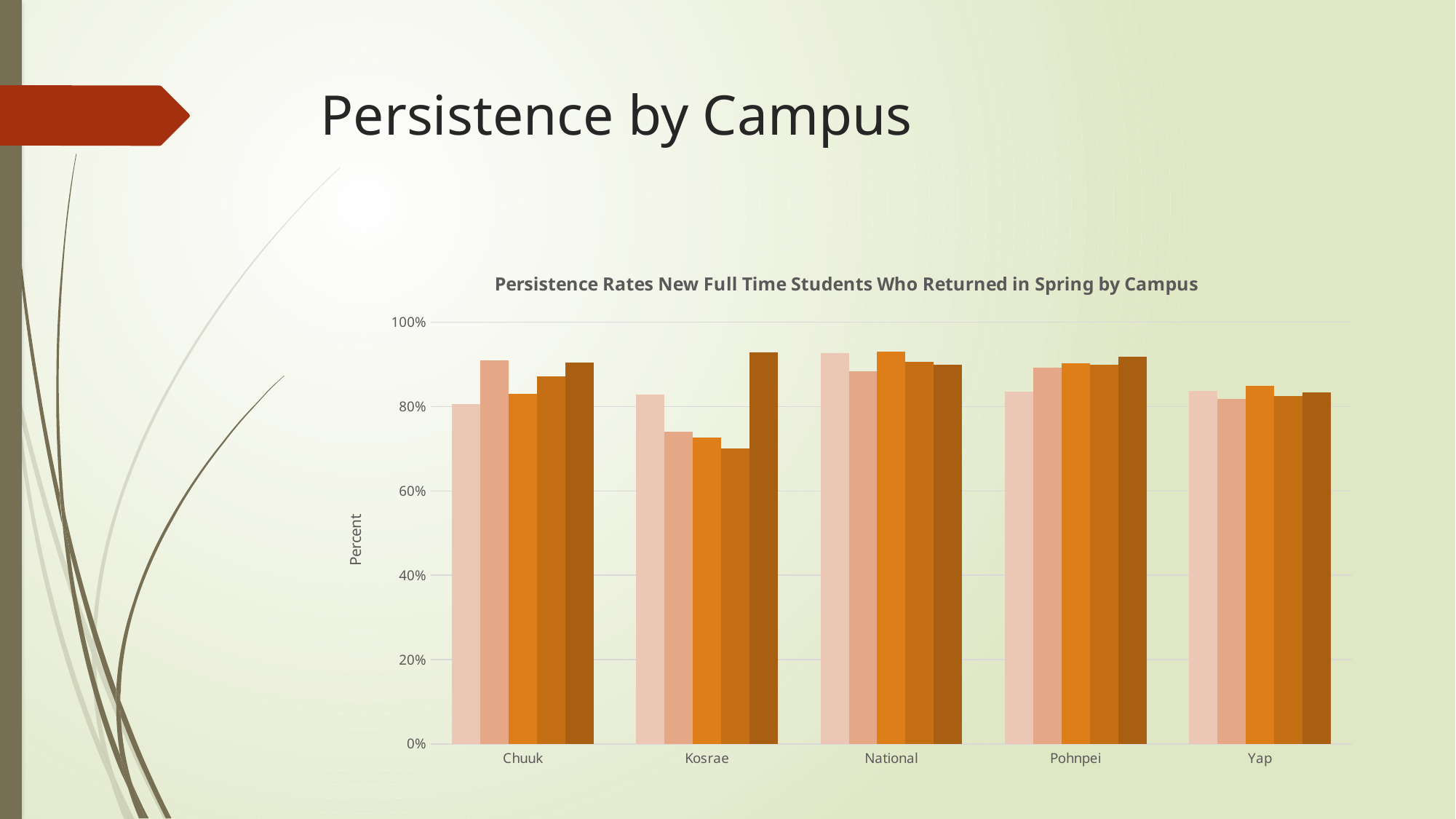
What kind of chart is shown on the slide? bar chart How many campuses are shown on the x axis of the chart? 5 Is the tallest bar for Kosrae greater or less than 90%? greater What is the label on the vertical axis of the chart? Percent What is the title of the chart? Persistence Rates New Full Time Students Who Returned in Spring by Campus How many bars are plotted for each campus in the chart? 5 Which campus has the lowest bar in the chart? Kosrae Are all the bars for Pohnpei greater or less than 60%? greater Which campus has a bar below 75%? Kosrae Is the lowest bar for Kosrae greater or less than 80%? less